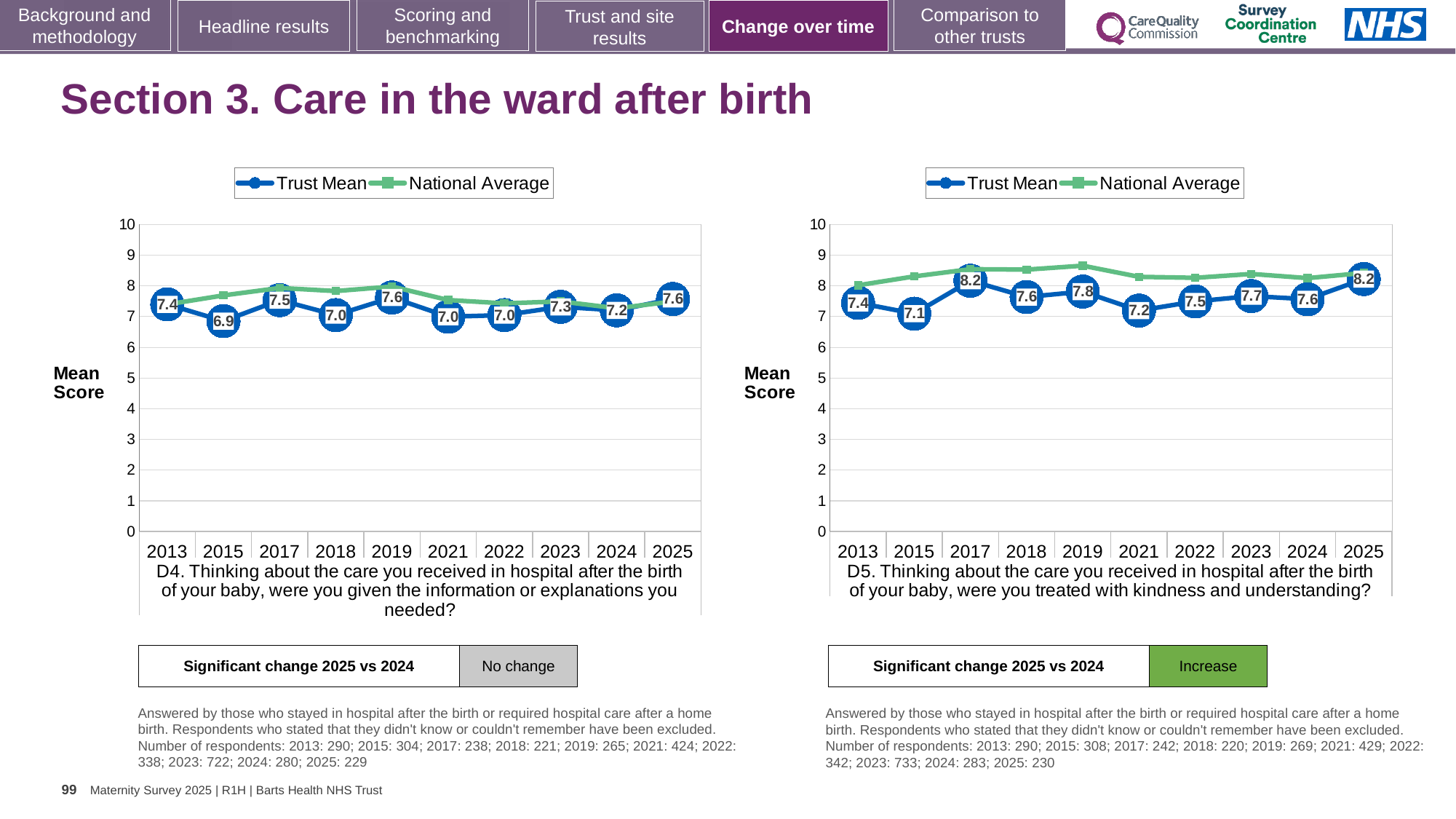
In the right chart (D5), which year has the lowest Trust Mean score? 2015 In the left chart (D4), what is the Trust Mean score for 2015? 6.9 In the right chart (D5), is the National Average value for 2019 greater or less than 8? greater In the left chart (D4), what is the Trust Mean score for 2025? 7.6 In the left chart (D4), which is larger, the Trust Mean score for 2017 or for 2018? 2017 In the right chart (D5), what is the Trust Mean score for 2021? 7.2 How many years are plotted on the x axis of the left chart (D4)? 10 In the right chart (D5), what is the Trust Mean score for 2017? 8.2 What type of chart is the left chart (D4)? Line chart How many series does the legend of the right chart (D5) list? 2 In the left chart (D4), which year has the lowest Trust Mean score? 2015 In the right chart (D5), what is the difference between the Trust Mean scores for 2025 and 2024? 0.6